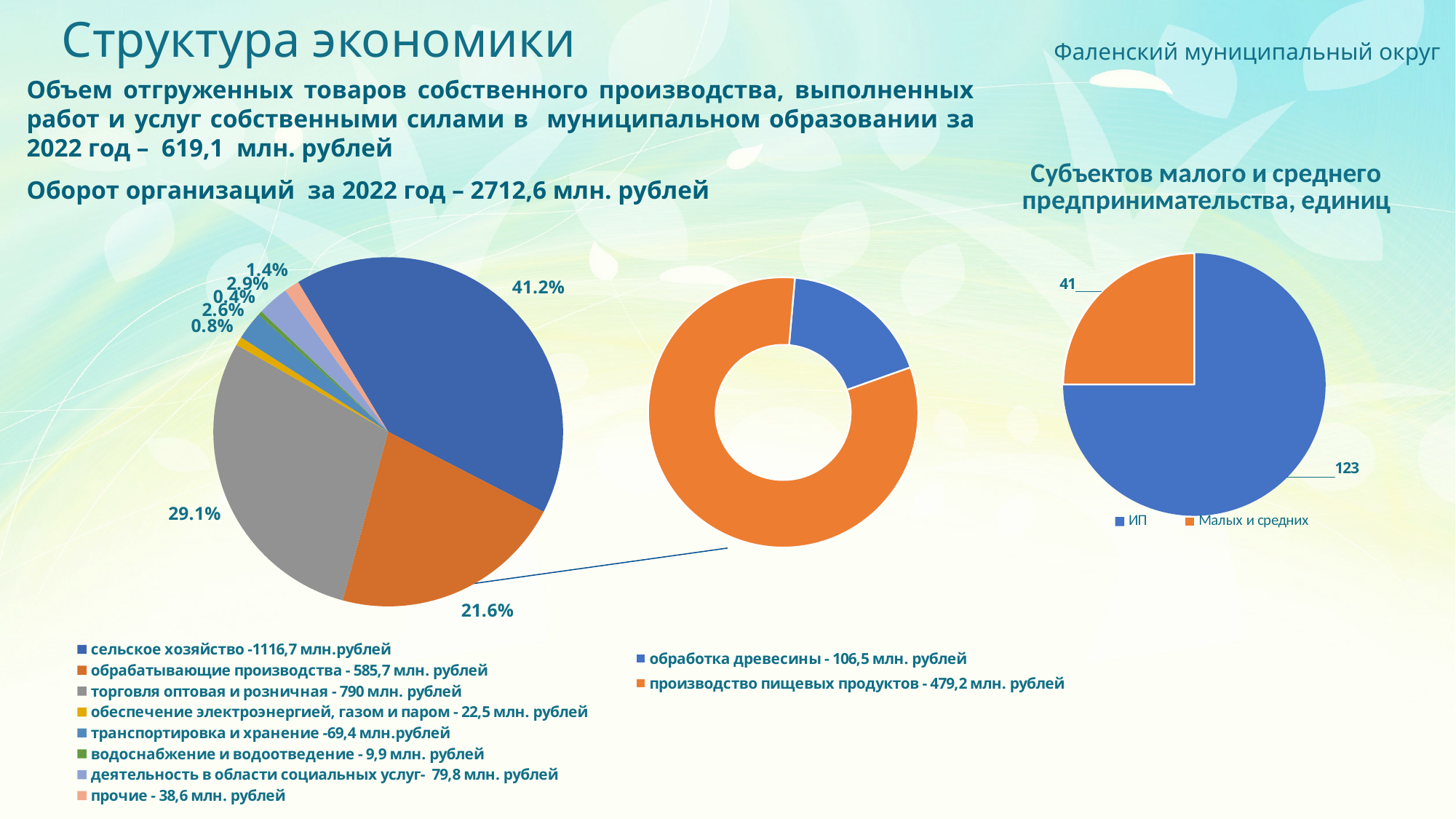
What kind of chart is the large chart on the left of the slide? Pie chart In the chart titled 'Субъектов малого и среднего предпринимательства, единиц', what is the difference between ИП and Малых и средних? 82 In the left pie chart, which category has the largest share? сельское хозяйство In the left pie chart, what is the difference between the shares of сельское хозяйство and обрабатывающие производства? 19.6% How many series does the legend of the middle donut chart list? 2 In the middle donut chart's legend, what value is given for обработка древесины? 106,5 млн. рублей In the left pie chart, what percentage is shown for сельское хозяйство? 41.2% How many categories does the legend of the left pie chart list? 8 In the chart titled 'Субъектов малого и среднего предпринимательства, единиц', what is the total of the two slices? 164 In the chart titled 'Субъектов малого и среднего предпринимательства, единиц', what is the value for ИП? 123 In the left pie chart, which category has the smallest share? водоснабжение и водоотведение In the left pie chart, what percentage is shown for торговля оптовая и розничная? 29.1%